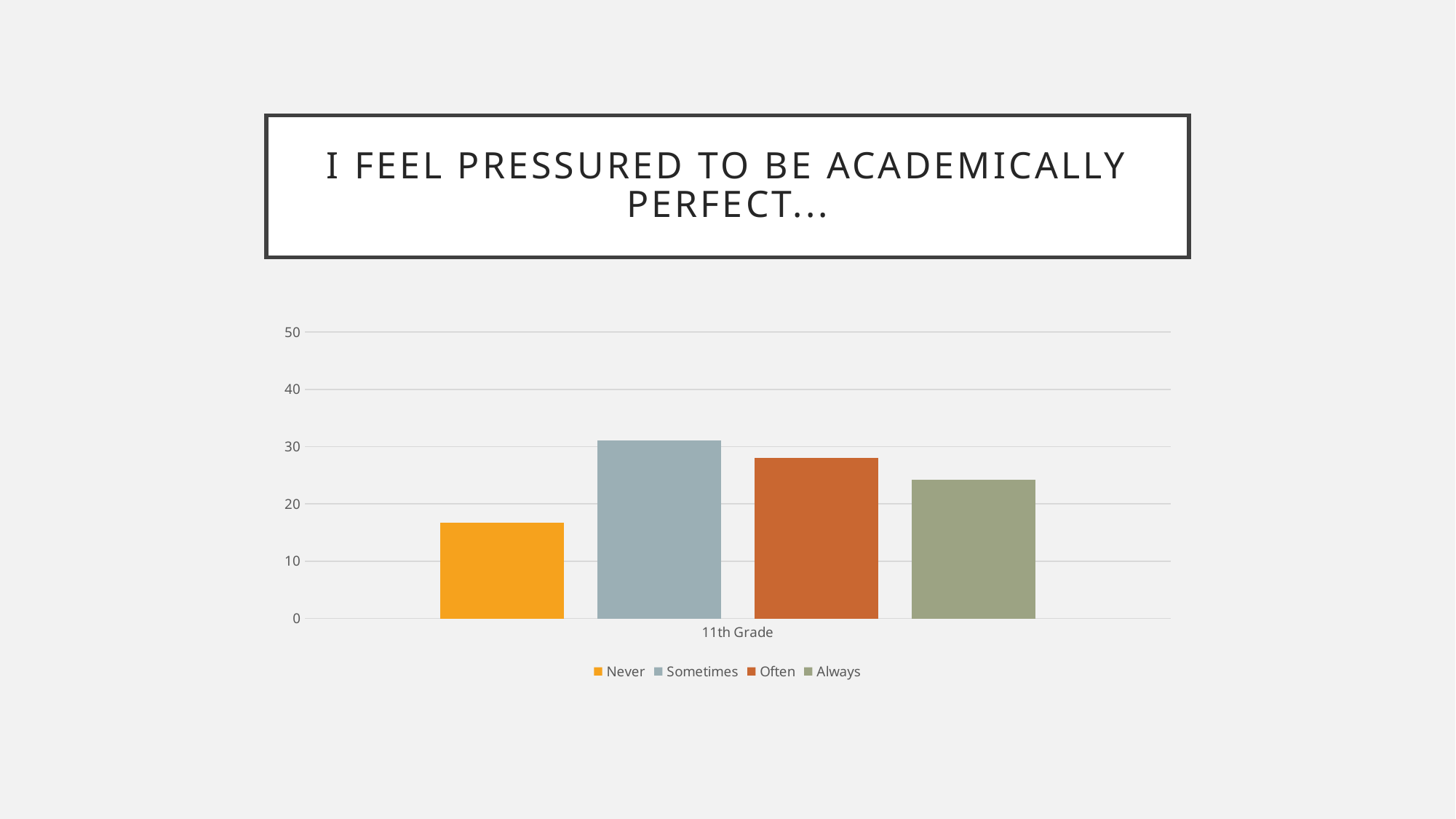
What is the title of the slide above the chart? I feel pressured to be academically perfect... Which response has the highest bar for 11th Grade? Sometimes What is the label of the category on the x axis? 11th Grade Which is larger, the value for Never or the value for Always? Always What kind of chart is shown on the slide? Bar chart Is the value for Never greater or less than 20? less Is the value for Always greater or less than 20? greater How many categories are shown on the x axis? 1 How many series does the legend list? 4 Is the value for Often greater or less than 30? less Which response has the lowest bar for 11th Grade? Never Which is larger, the value for Often or the value for Always? Often